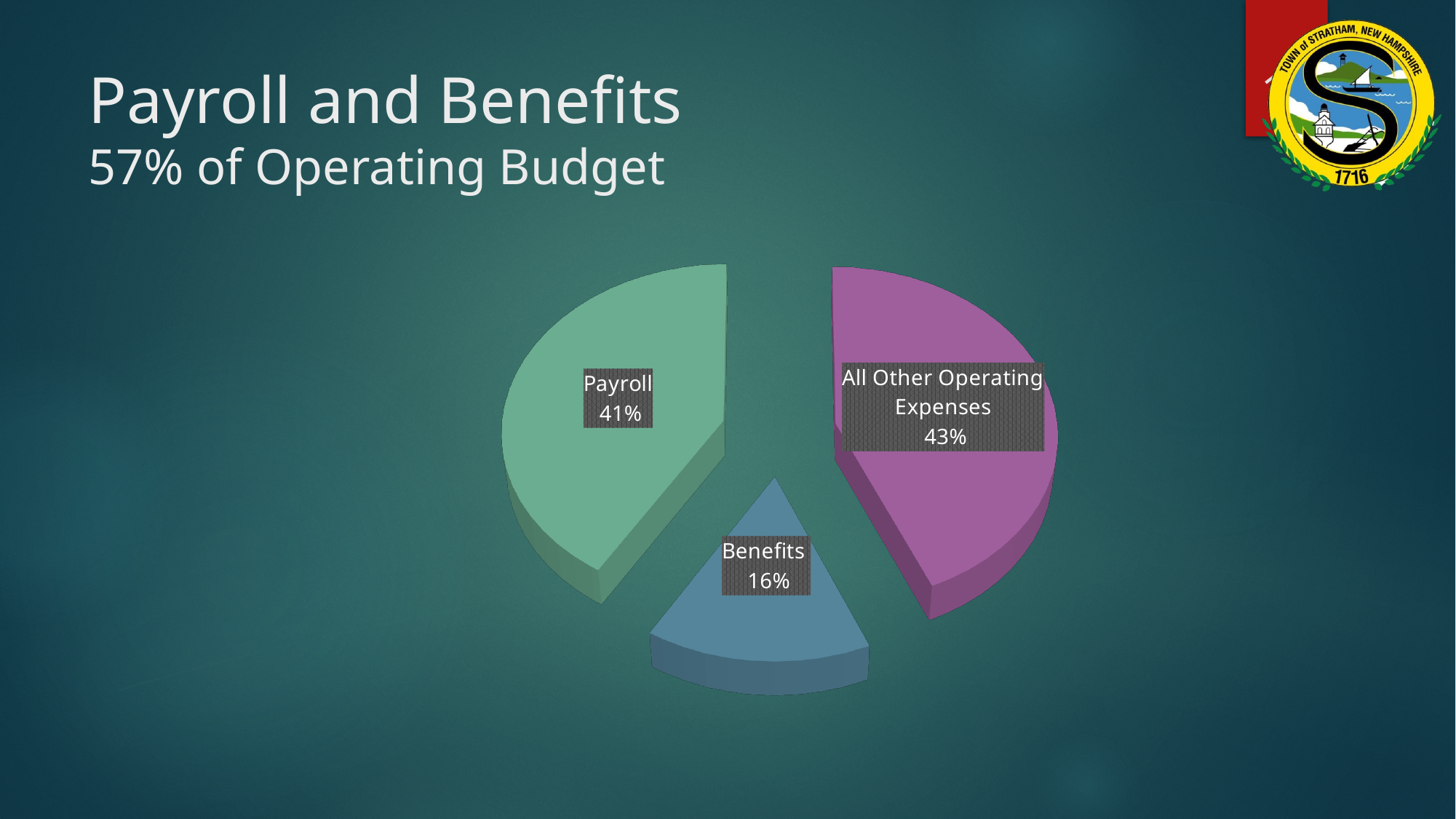
What share of the pie does All Other Operating Expenses represent? 43% What kind of chart is shown on the slide? Pie chart What colour is the Benefits slice? Blue What is the combined share of Payroll and Benefits? 57% What is the difference in percentage points between Payroll and Benefits? 25 What share of the pie does Benefits represent? 16% How many slices does the pie chart have? 3 What is the title of the slide? Payroll and Benefits Which slice of the pie is the largest? All Other Operating Expenses What share of the pie does Payroll represent? 41% Which is larger, Payroll or Benefits? Payroll Which slice of the pie is the smallest? Benefits